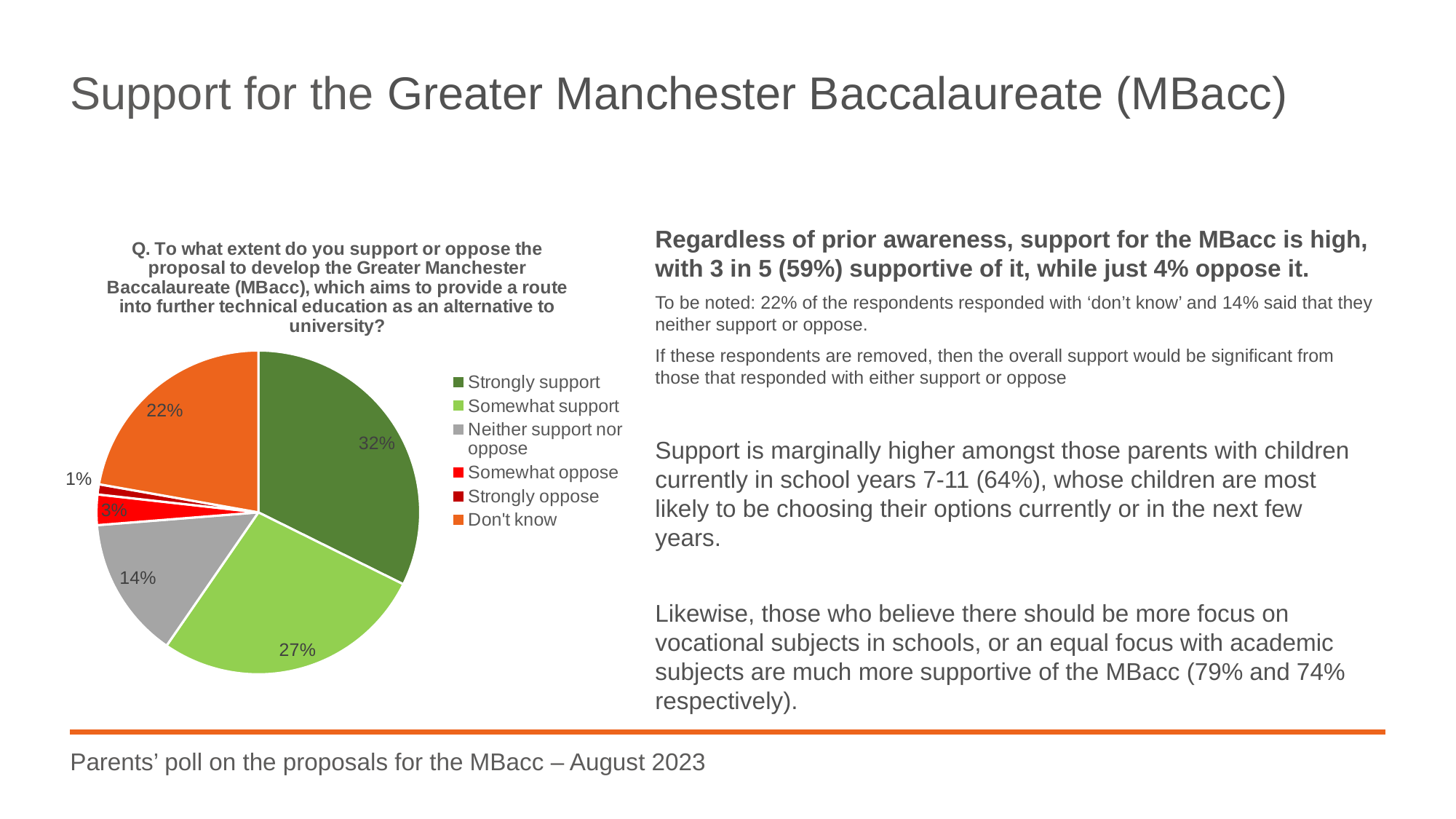
What is the combined percentage of 'Somewhat oppose' and 'Strongly oppose'? 4% What percentage of respondents neither support nor oppose the proposal? 14% What percentage of respondents answered 'Don't know'? 22% What is the difference in percentage points between 'Strongly support' and 'Somewhat support'? 5 Which response category has the smallest share of the pie? Strongly oppose What percentage of respondents said they strongly support the MBacc proposal? 32% What percentage of respondents said they somewhat oppose the proposal? 3% What colour is the 'Don't know' slice in the pie chart? Orange How many response categories does the pie chart show? 6 Which response category has the largest share of the pie? Strongly support What kind of chart is shown on the slide? Pie chart Which is larger, the share for 'Don't know' or the share for 'Neither support nor oppose'? Don't know